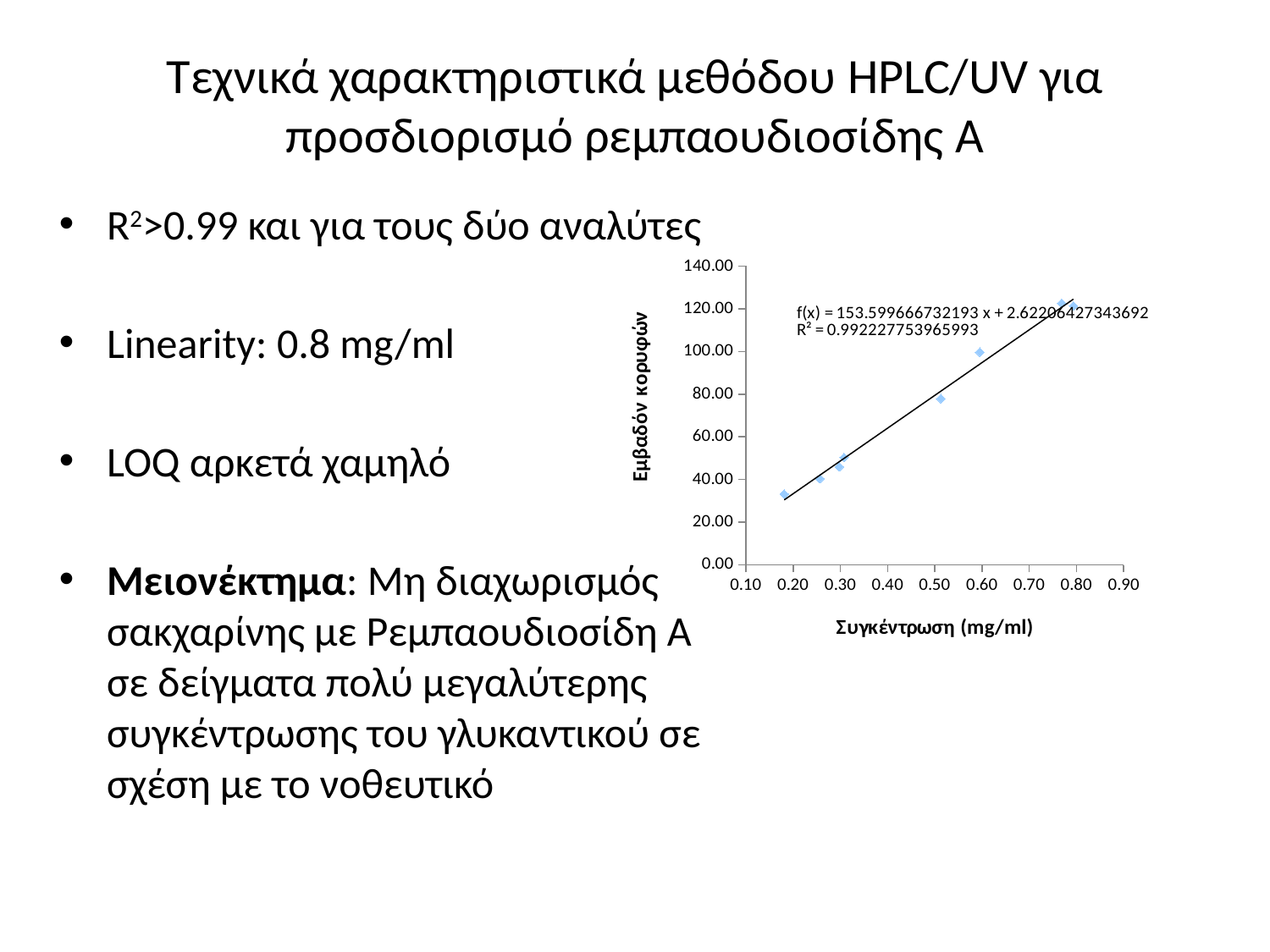
What is the title of the y axis of the chart? Εμβαδόν κορυφών What is the title of the x axis of the chart? Συγκέντρωση (mg/ml) Which point has the larger peak area: the one at about 0.60 mg/ml or the one at about 0.30 mg/ml? the one at about 0.60 mg/ml Is the peak area value for the point at about 0.52 mg/ml greater or less than 60? greater Is the peak area value for the rightmost point greater or less than 100? greater Is the peak area value for the point at about 0.60 mg/ml greater or less than 80? greater What is the R² value printed on the chart? 0.992227753965993 Do the plotted values rise or fall as concentration increases along the x axis? rise What is the slope of the fitted line shown in the equation on the chart? 153.599666732193 What kind of chart is shown on the slide? scatter chart What is the intercept of the fitted line shown in the equation on the chart? 2.62206427343692